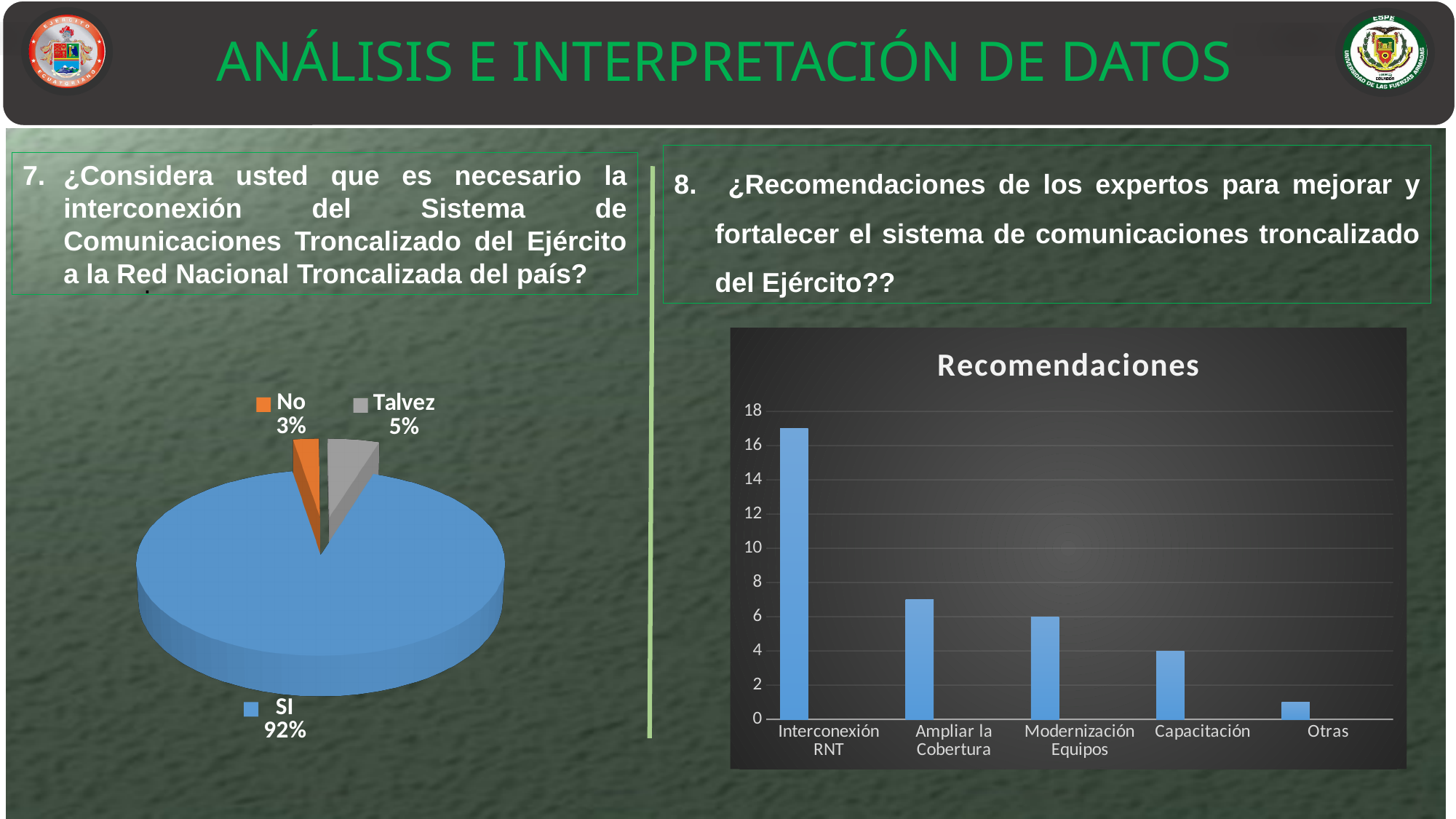
On the 'Recomendaciones' chart, how many categories are shown on the x axis? 5 What kind of chart is the 'Recomendaciones' chart on the right? Bar chart On the pie chart on the left, what percentage of respondents answered Talvez? 5% On the pie chart on the left, which response has the smallest share? No On the 'Recomendaciones' chart, which category has the lowest value? Otras On the 'Recomendaciones' chart, is the value for Interconexión RNT greater or less than 16? greater On the pie chart on the left, how many slices does the pie have? 3 On the 'Recomendaciones' chart, which category has the highest value? Interconexión RNT On the pie chart on the left, what is the difference in percentage points between SI and Talvez? 87 On the 'Recomendaciones' chart, what is the value for Modernización Equipos? 6 On the pie chart on the left, what percentage of respondents answered No? 3% On the pie chart on the left, what percentage of respondents answered SI? 92%